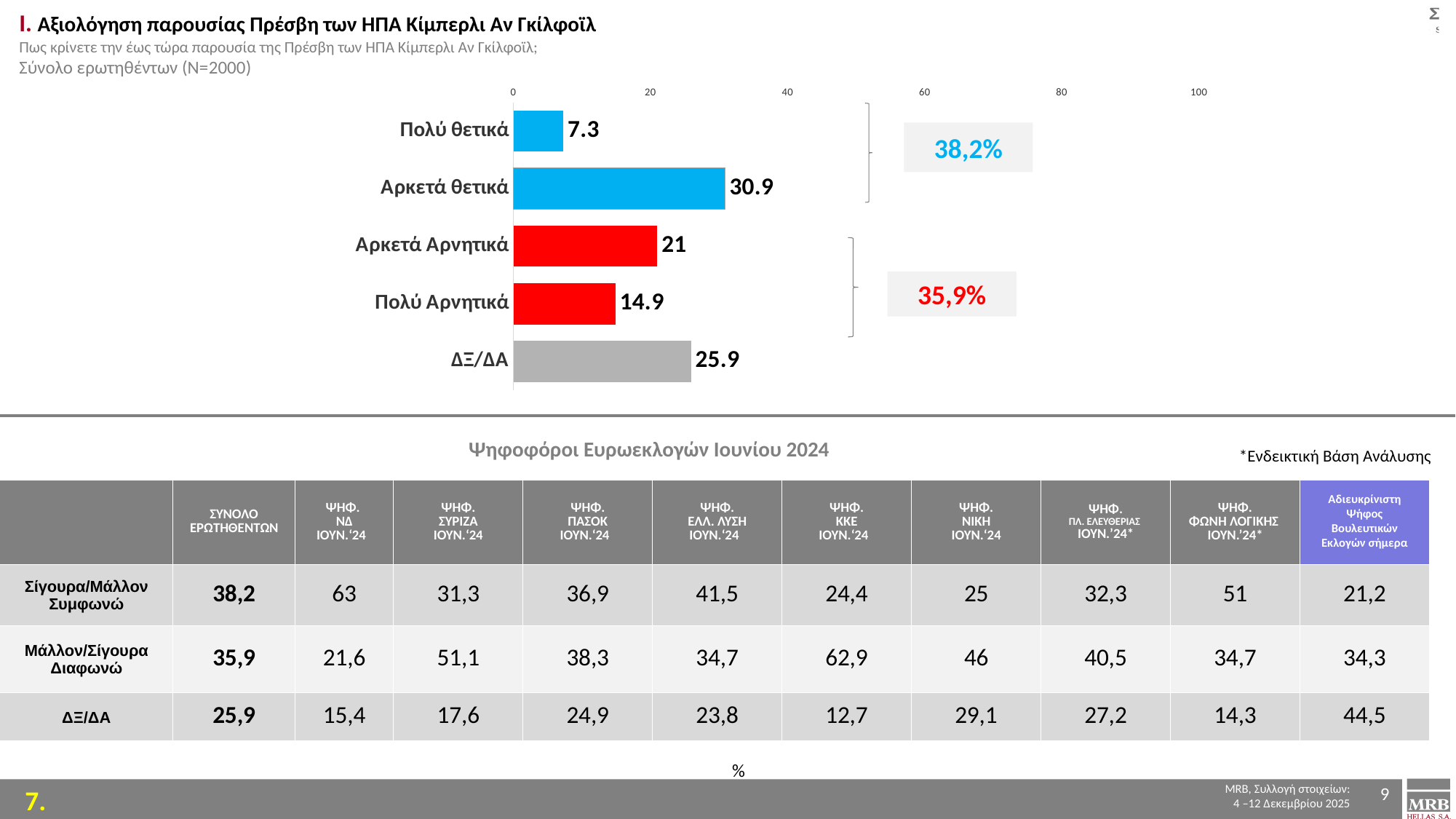
Which is larger, the value for ΔΞ/ΔΑ or the value for Αρκετά Αρνητικά? ΔΞ/ΔΑ What kind of chart is shown on the slide? bar chart What is the value for Πολύ Αρνητικά? 14.9 What combined percentage is shown in the box next to the two positive categories (Πολύ θετικά and Αρκετά θετικά)? 38,2% What is the value for Πολύ θετικά? 7.3 What is the value for Αρκετά Αρνητικά? 21 How many categories does the bar chart show? 5 Which category has the lowest value? Πολύ θετικά Which category has the highest value? Αρκετά θετικά What is the difference between the values for Αρκετά θετικά and Αρκετά Αρνητικά? 9.9 What is the value for ΔΞ/ΔΑ? 25.9 What is the value for Αρκετά θετικά? 30.9